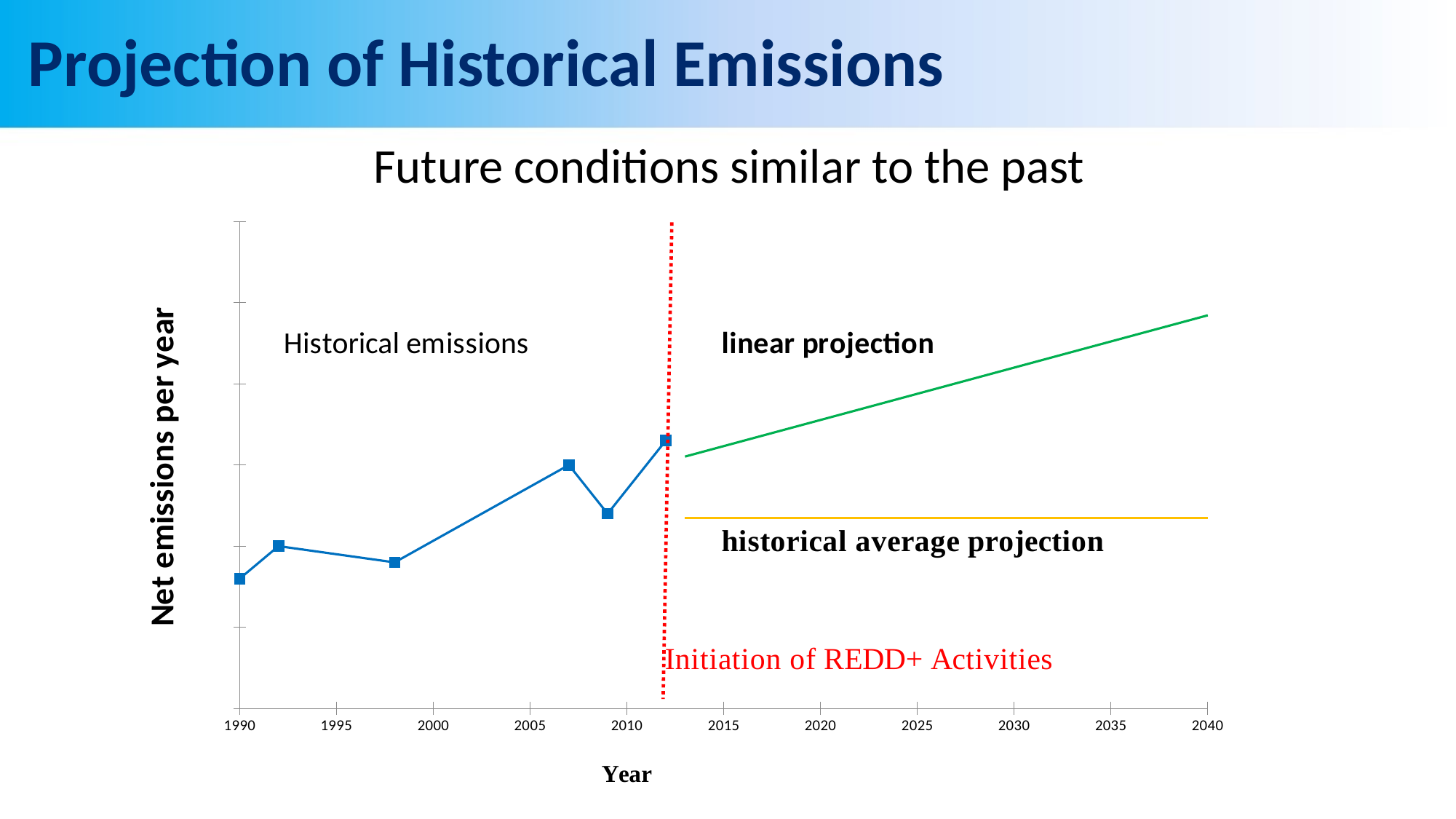
Which projection line is higher in 2040, the linear projection or the historical average projection? linear projection Which year has the higher historical emissions value, 1992 or 1998? 1992 Do historical emissions rise or fall between 2009 and 2012? rise How many data points are plotted on the historical emissions line? 6 In which year does the historical emissions line have its lowest value? 1990 Does the linear projection line rise or fall from 2013 to 2040? rises In which year does the historical emissions line reach its highest value? 2012 What is the label on the y axis of the chart? Net emissions per year What event does the red dotted vertical line mark? Initiation of REDD+ Activities What kind of chart is shown on the slide? line chart Which year has the higher historical emissions value, 2007 or 2009? 2007 Does the historical average projection line rise, fall, or stay flat from 2013 to 2040? stays flat